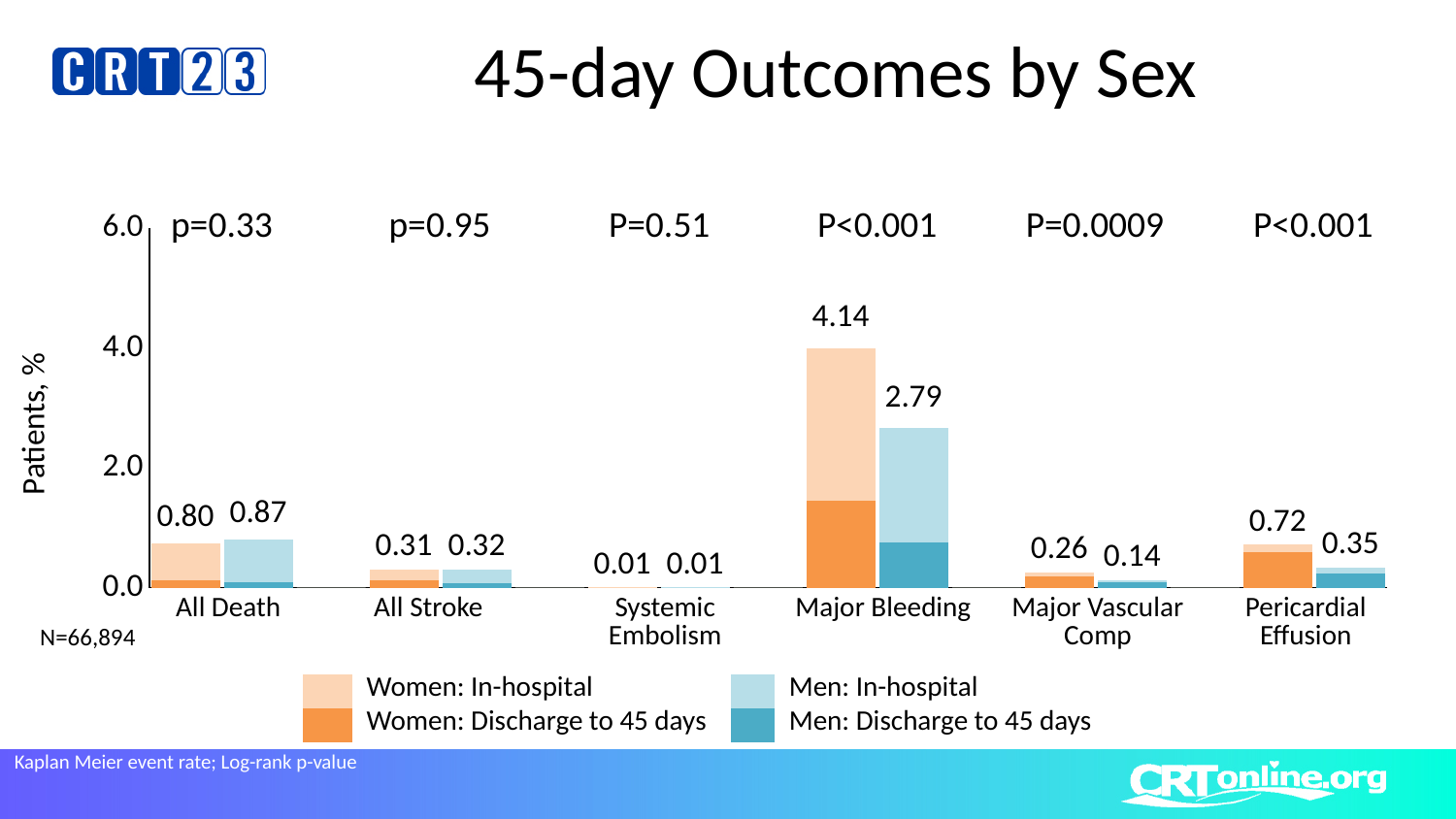
Which outcome category has the lowest event rates on the chart? Systemic Embolism How many series does the legend list? 4 For Major Vascular Comp, which is larger: the women's total or the men's total? Women's total Is the women's total value for Major Bleeding greater or less than 4.0? greater What is the total 45-day event rate for women for Major Bleeding? 4.14 What is the total value shown for men for All Death? 0.87 What is the total 45-day event rate for men for Major Bleeding? 2.79 Which outcome category has the highest event rate on the chart? Major Bleeding How many outcome categories are shown on the x axis? 6 What is the total value shown for women for Pericardial Effusion? 0.72 What is the difference between the women's and men's total values for Major Bleeding? 1.35 What kind of chart is shown on the slide? Stacked bar chart